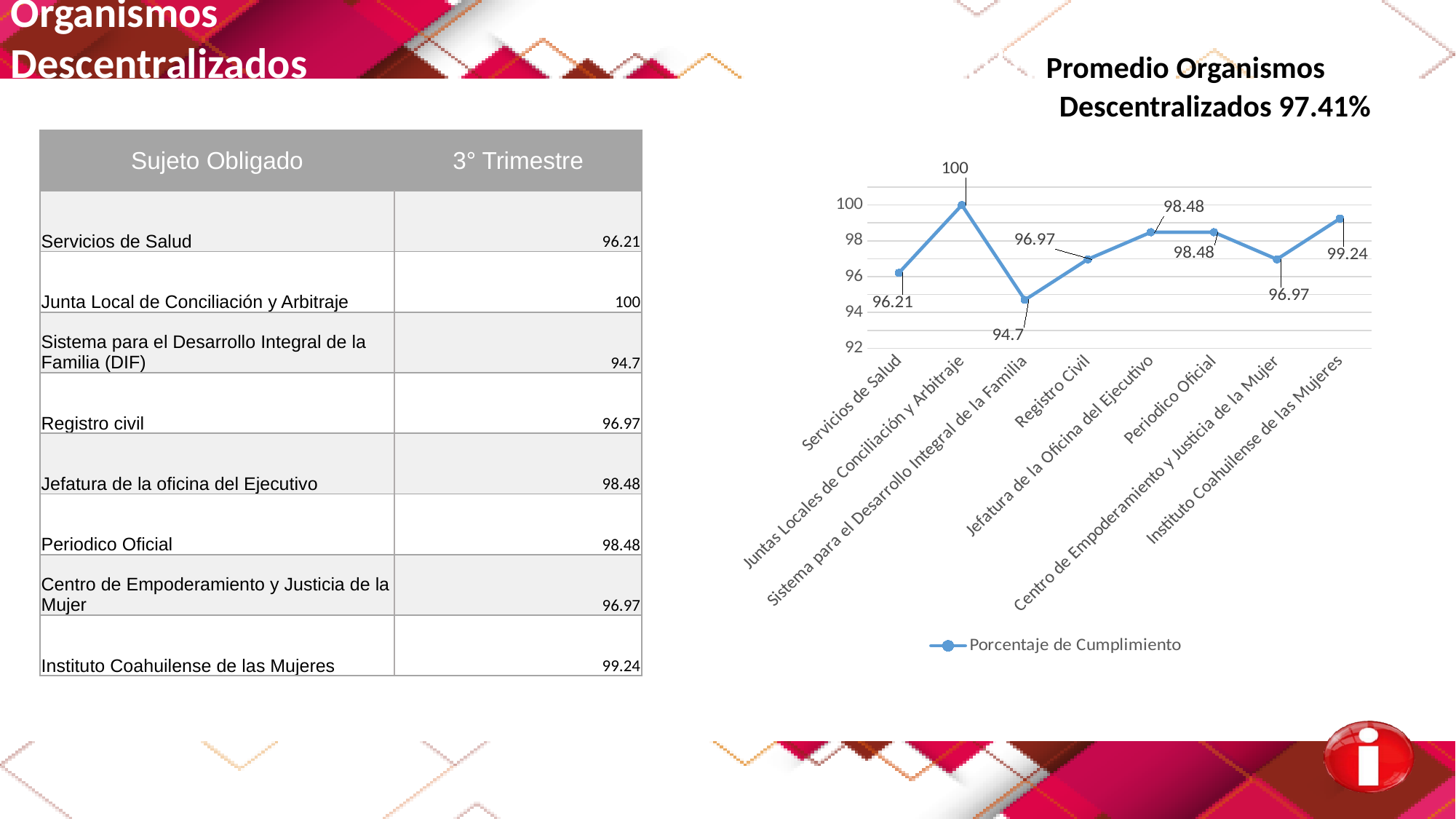
What is the value for Instituto Coahuilense de las Mujeres in the line chart? 99.24 Is the value for Sistema para el Desarrollo Integral de la Familia greater or less than 96? less Which category has the lowest value in the line chart? Sistema para el Desarrollo Integral de la Familia Which is larger, the value for Instituto Coahuilense de las Mujeres or the value for Periodico Oficial? Instituto Coahuilense de las Mujeres Which category has the highest value in the line chart? Juntas Locales de Conciliación y Arbitraje What is the difference between the values for Juntas Locales de Conciliación y Arbitraje and Sistema para el Desarrollo Integral de la Familia? 5.3 What is the value for Registro Civil in the line chart? 96.97 How many categories are plotted in the line chart? 8 What is the name of the series shown in the chart legend? Porcentaje de Cumplimiento How many series does the chart legend list? 1 What kind of chart is shown on the slide? line chart What is the value for Servicios de Salud in the line chart? 96.21